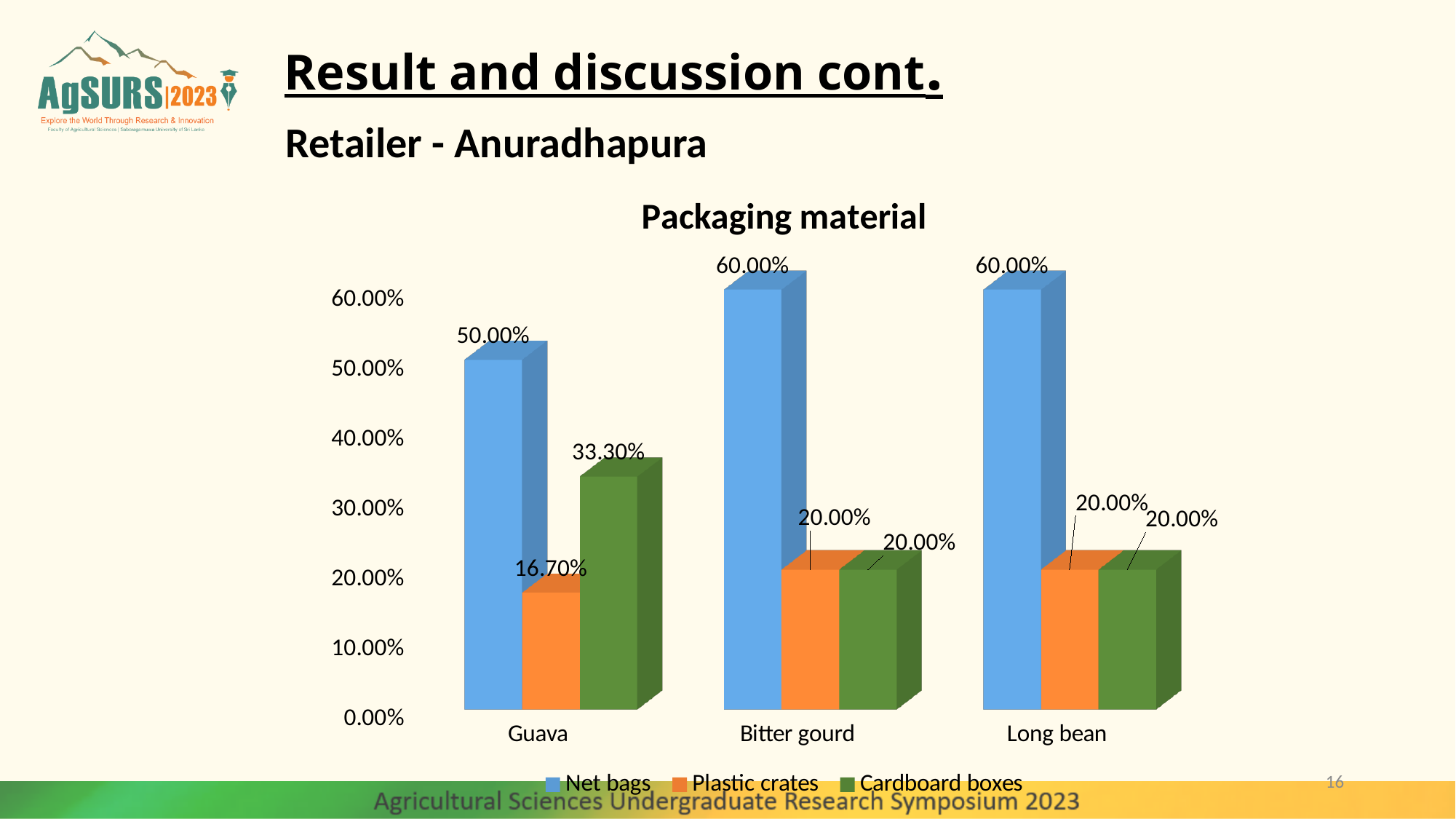
What is the value for Net bags for Guava? 50.00% What is the difference between the Net bags and Plastic crates values for Guava? 33.30% What is the value for Cardboard boxes for Long bean? 20.00% What is the value for Net bags for Bitter gourd? 60.00% Which category has the highest value for Cardboard boxes? Guava What is the value for Cardboard boxes for Guava? 33.30% Which category has the lowest value for Net bags? Guava What is the value for Plastic crates for Guava? 16.70% How many series does the legend list? 3 What kind of chart is shown? Bar chart How many categories are shown on the x axis? 3 Which is larger for Guava, Cardboard boxes or Plastic crates? Cardboard boxes